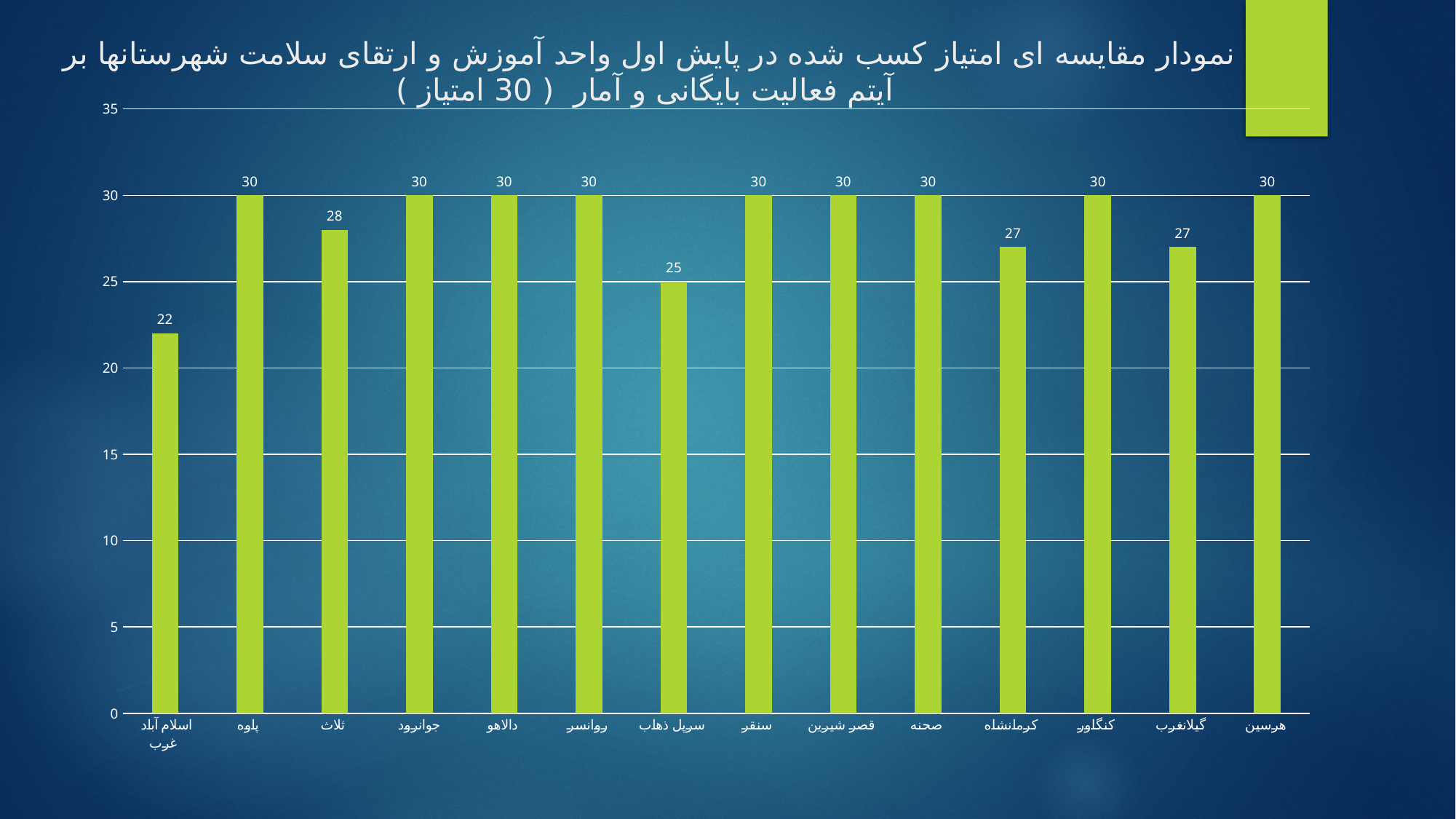
What is the difference between the values for ثلاث and سرپل ذهاب? 3 What is the value for اسلام آباد غرب? 22 What is the value for سرپل ذهاب? 25 What is the difference between the values for پاوه and اسلام آباد غرب? 8 What kind of chart is shown on the slide? bar chart Which city has the lowest value in the chart? اسلام آباد غرب How many cities have a value of 30 in the chart? 9 How many cities (categories) are shown on the x axis of the chart? 14 What is the value for ثلاث? 28 What is the value for کرمانشاه? 27 Which is larger, the value for گیلانغرب or the value for سرپل ذهاب? گیلانغرب What is the maximum score mentioned in the chart title? 30 امتیاز